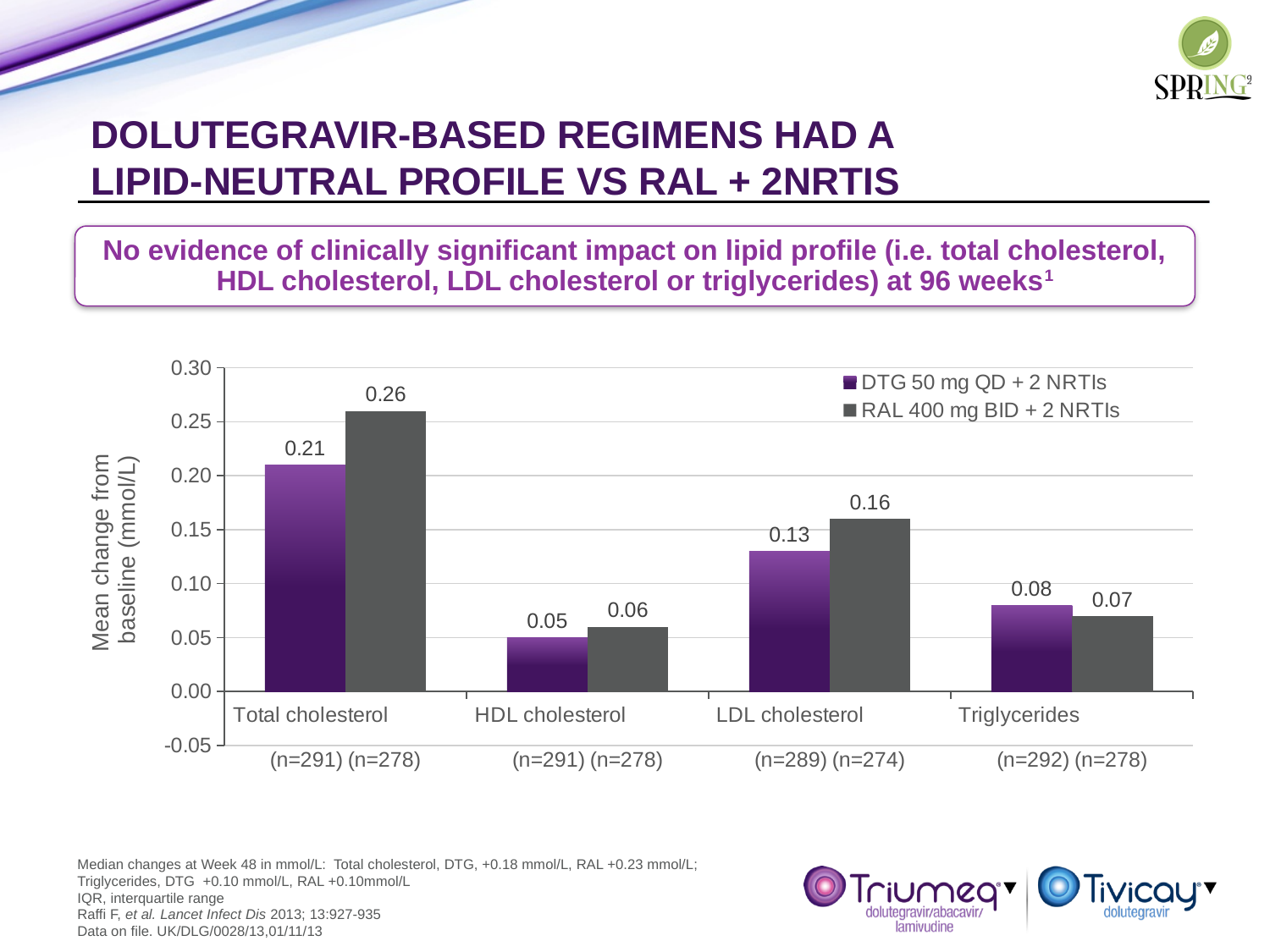
How many series does the chart legend list? 2 What is the mean change from baseline in total cholesterol for DTG 50 mg QD + 2 NRTIs? 0.21 What is the mean change from baseline in triglycerides for DTG 50 mg QD + 2 NRTIs? 0.08 Which lipid parameter shows the highest mean change from baseline for RAL 400 mg BID + 2 NRTIs? Total cholesterol Which lipid parameter shows the lowest mean change from baseline for DTG 50 mg QD + 2 NRTIs? HDL cholesterol What kind of chart is shown on the slide? Bar chart What is the label of the y axis of the chart? Mean change from baseline (mmol/L) For triglycerides, which regimen has the larger mean change from baseline? DTG 50 mg QD + 2 NRTIs What is the difference between the RAL and DTG mean changes from baseline in total cholesterol? 0.05 How many lipid parameters are shown on the x axis of the chart? 4 For LDL cholesterol, which regimen has the larger mean change from baseline? RAL 400 mg BID + 2 NRTIs What is the mean change from baseline in LDL cholesterol for RAL 400 mg BID + 2 NRTIs? 0.16